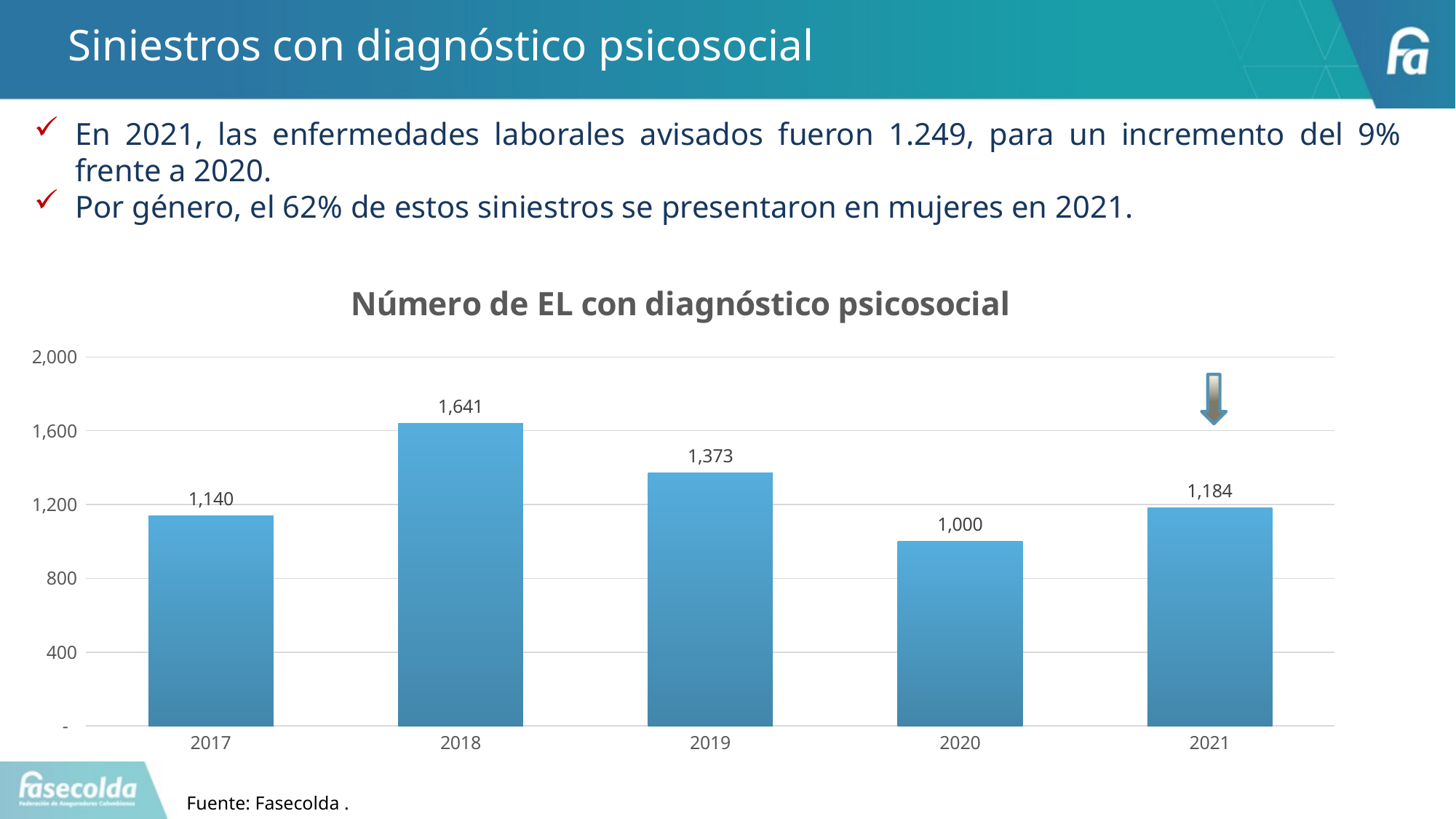
What is the title of the chart? Número de EL con diagnóstico psicosocial What is the value for 2020? 1,000 What is the difference between the values for 2021 and 2020? 184 Which year has the lowest value? 2020 What is the value for 2018? 1,641 What is the difference between the values for 2018 and 2019? 268 Which year has the highest value? 2018 What is the value for 2021? 1,184 Which is larger, the value for 2017 or the value for 2021? 2021 Is the value for 2019 greater or less than 1,200? greater What kind of chart is shown? bar chart How many years are shown on the x axis? 5